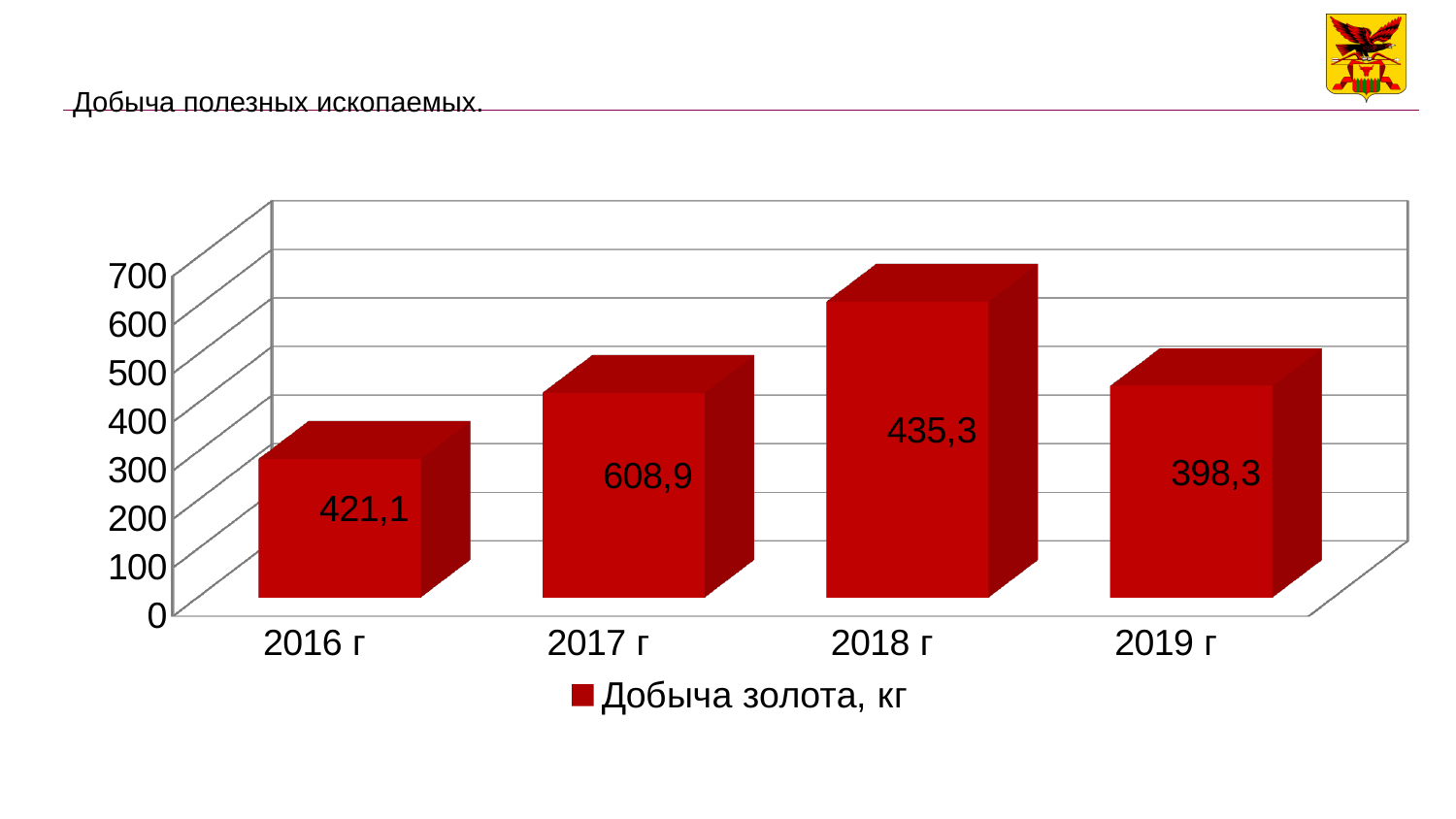
How many series does the legend list? 1 What is the difference between the labelled values for 2017 г and 2018 г? 173,6 What is the difference between the labelled values for 2018 г and 2019 г? 37 What is the difference between the labelled values for 2016 г and 2019 г? 22,8 What is the value shown for 2016 г? 421,1 What is the title text at the top of the slide? Добыча полезных ископаемых. What is the name of the series in the legend? Добыча золота, кг What is the value shown for 2019 г? 398,3 What is the value shown for 2017 г? 608,9 What kind of chart is shown on the slide? Bar chart How many years are shown on the x axis of the chart? 4 What is the value shown for 2018 г? 435,3